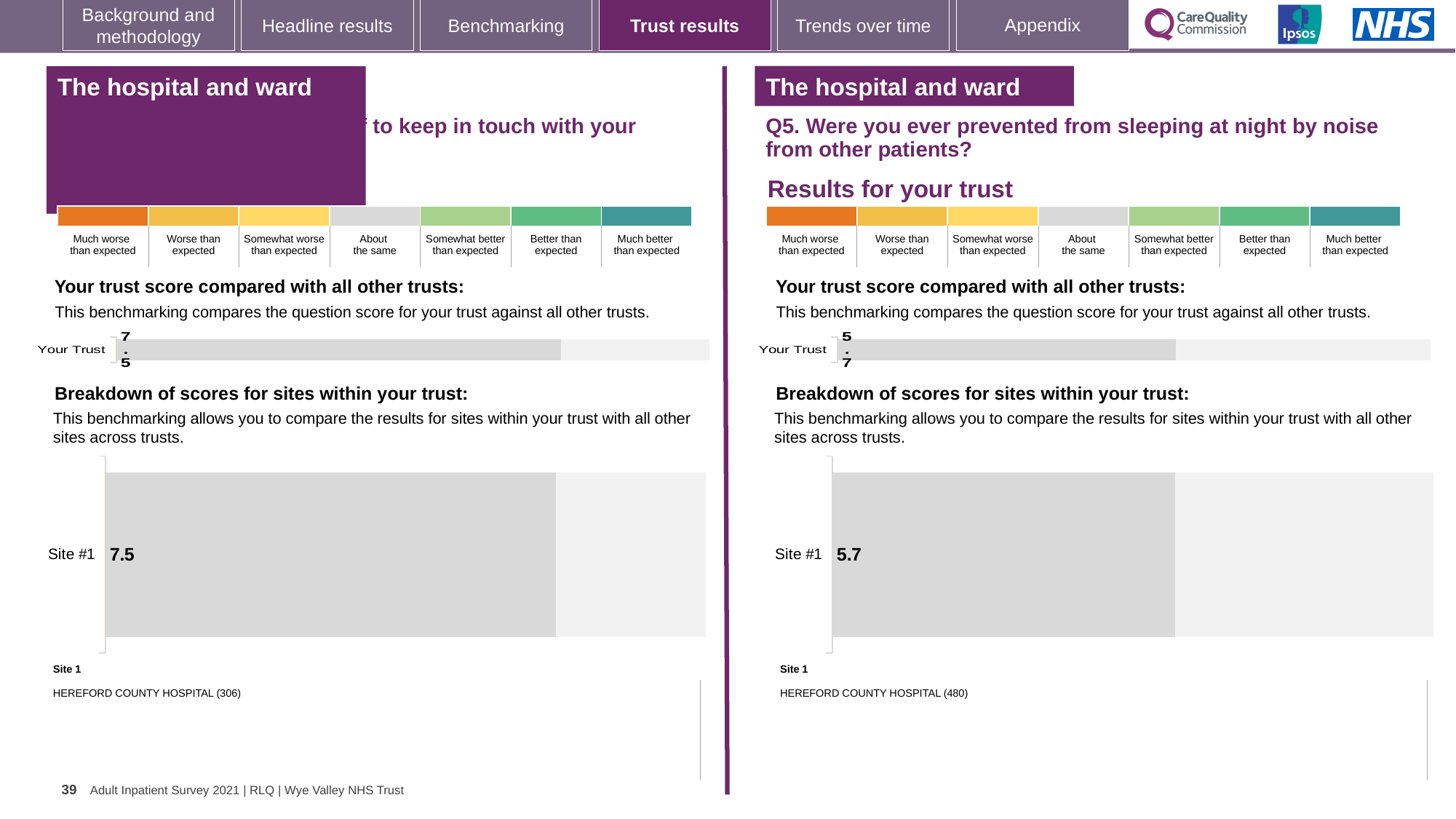
Which hospital is listed as Site 1 beneath the left-hand chart? HEREFORD COUNTY HOSPITAL (306) Is the Site #1 score on the right-hand Q5 chart greater or less than the Site #1 score on the left-hand chart? less What is the difference between the Site #1 score on the left-hand chart and the Site #1 score on the right-hand Q5 chart? 1.8 Which hospital is listed as Site 1 beneath the right-hand Q5 chart? HEREFORD COUNTY HOSPITAL (480) What type of chart is used to show the Site #1 score on the right-hand Q5 chart? Bar chart How many sites are shown in the left-hand breakdown of scores for sites within your trust? 1 Which is larger: the Your Trust score on the left-hand chart or the Your Trust score on the right-hand Q5 chart? Left-hand chart (7.5) How many sites are shown in the right-hand breakdown of scores for sites within your trust (Q5)? 1 In the right-hand breakdown of scores for sites within your trust (Q5), what score is shown for Site #1? 5.7 In the left-hand breakdown of scores for sites within your trust, what score is shown for Site #1? 7.5 On the right-hand chart for Q5 (prevented from sleeping at night by noise from other patients), what is the score shown for Your Trust? 5.7 On the left-hand chart, what is the score shown for Your Trust? 7.5